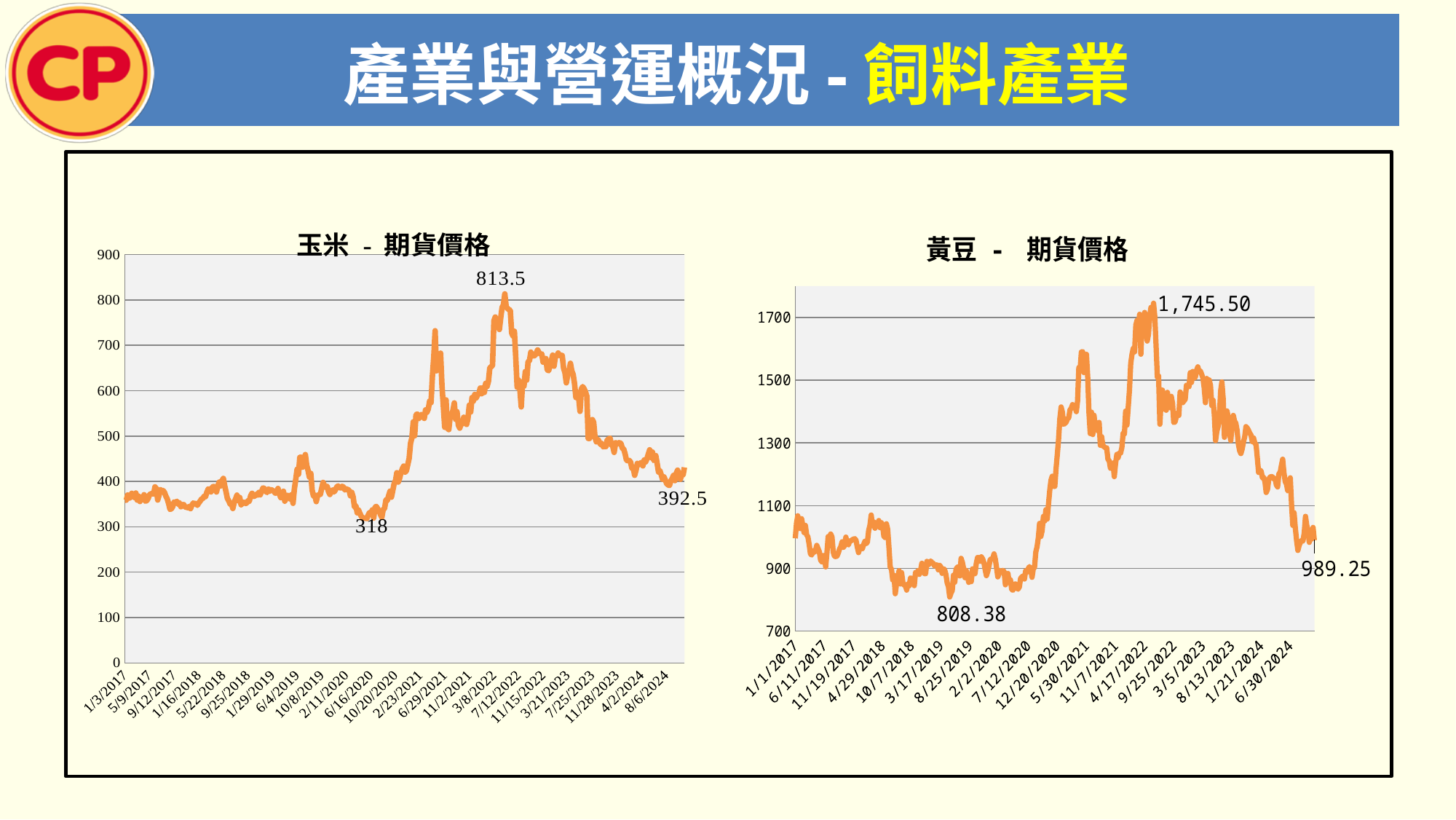
In the 玉米 - 期貨價格 chart, what is the difference between the peak label 813.5 and the low label 318? 495.5 In the 玉米 - 期貨價格 chart, what is the highest labelled value? 813.5 In the 黃豆 - 期貨價格 chart, what is the value labelled at the end of the line (near 6/30/2024)? 989.25 In the 黃豆 - 期貨價格 chart, is the value at 1/1/2017 greater or less than 1300? less What kind of chart is the 玉米 - 期貨價格 chart? Line chart In the 玉米 - 期貨價格 chart, what is the value labelled at the end of the line (near 8/6/2024)? 392.5 In the 玉米 - 期貨價格 chart, is the value at 1/3/2017 greater or less than 500? less In the 黃豆 - 期貨價格 chart, which is larger: the peak label 1,745.50 or the end label 989.25? 1,745.50 In the 黃豆 - 期貨價格 chart, what is the lowest labelled value? 808.38 In the 玉米 - 期貨價格 chart, what is the lowest labelled value? 318 In the 黃豆 - 期貨價格 chart, what is the highest labelled value? 1,745.50 In the 黃豆 - 期貨價格 chart, what is the difference between the peak label 1,745.50 and the low label 808.38? 937.12